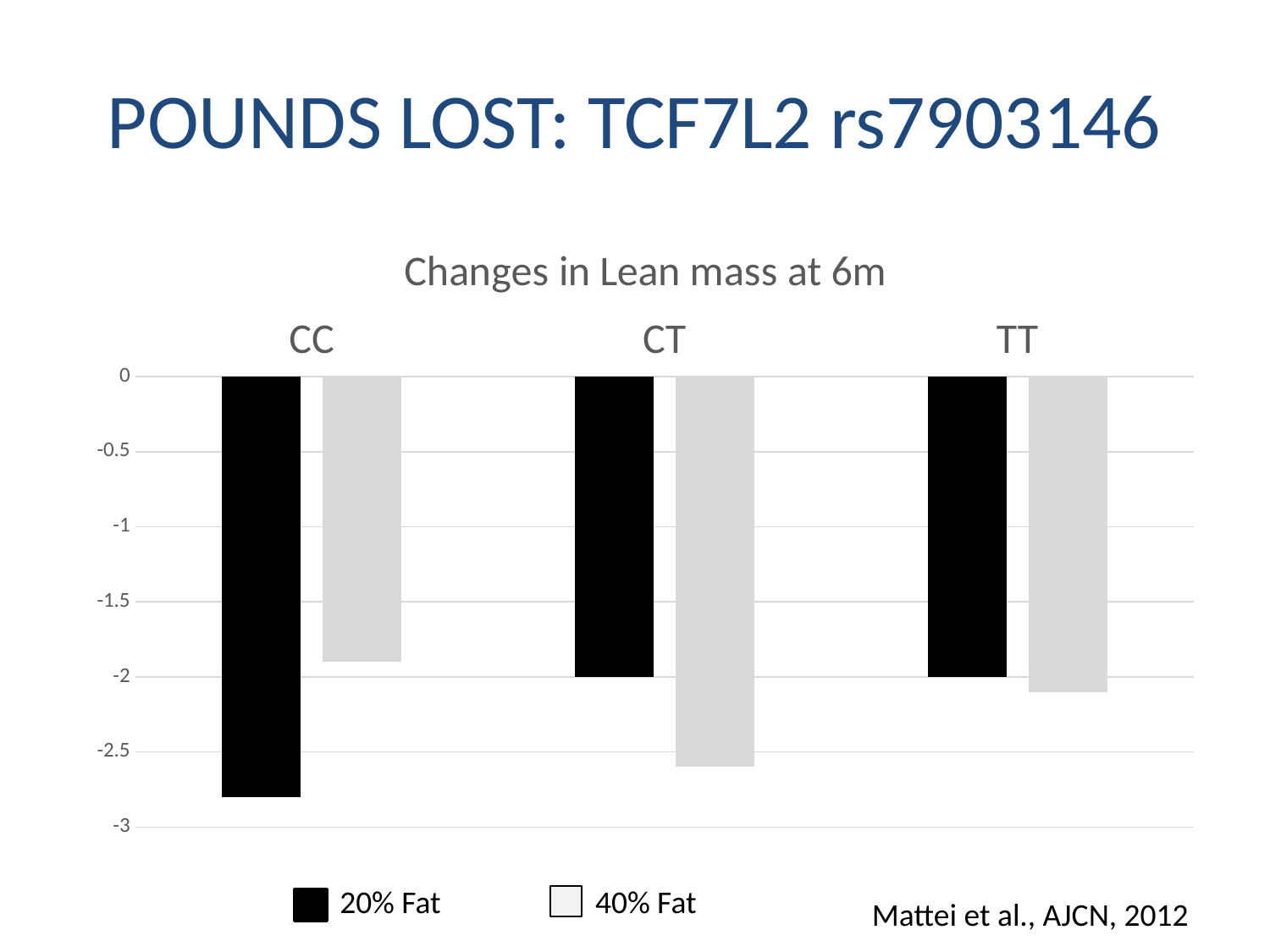
Is the value for 40% Fat in the CC category greater or less than -2? greater How many series does the legend list? 2 How many genotype categories are shown on the x axis? 3 Is the value for 20% Fat in the CC category greater or less than -2.5? less In the CC category, which series has the more negative value, 20% Fat or 40% Fat? 20% Fat What kind of chart is shown on the slide? bar chart Which category has the most negative value for the 20% Fat series? CC Is the value for 40% Fat in the CT category greater or less than -2.5? less Which colour represents the 40% Fat series? light gray What is the title of the chart? Changes in Lean mass at 6m What is the value for 20% Fat in the CT category? -2 Which category has the most negative value for the 40% Fat series? CT